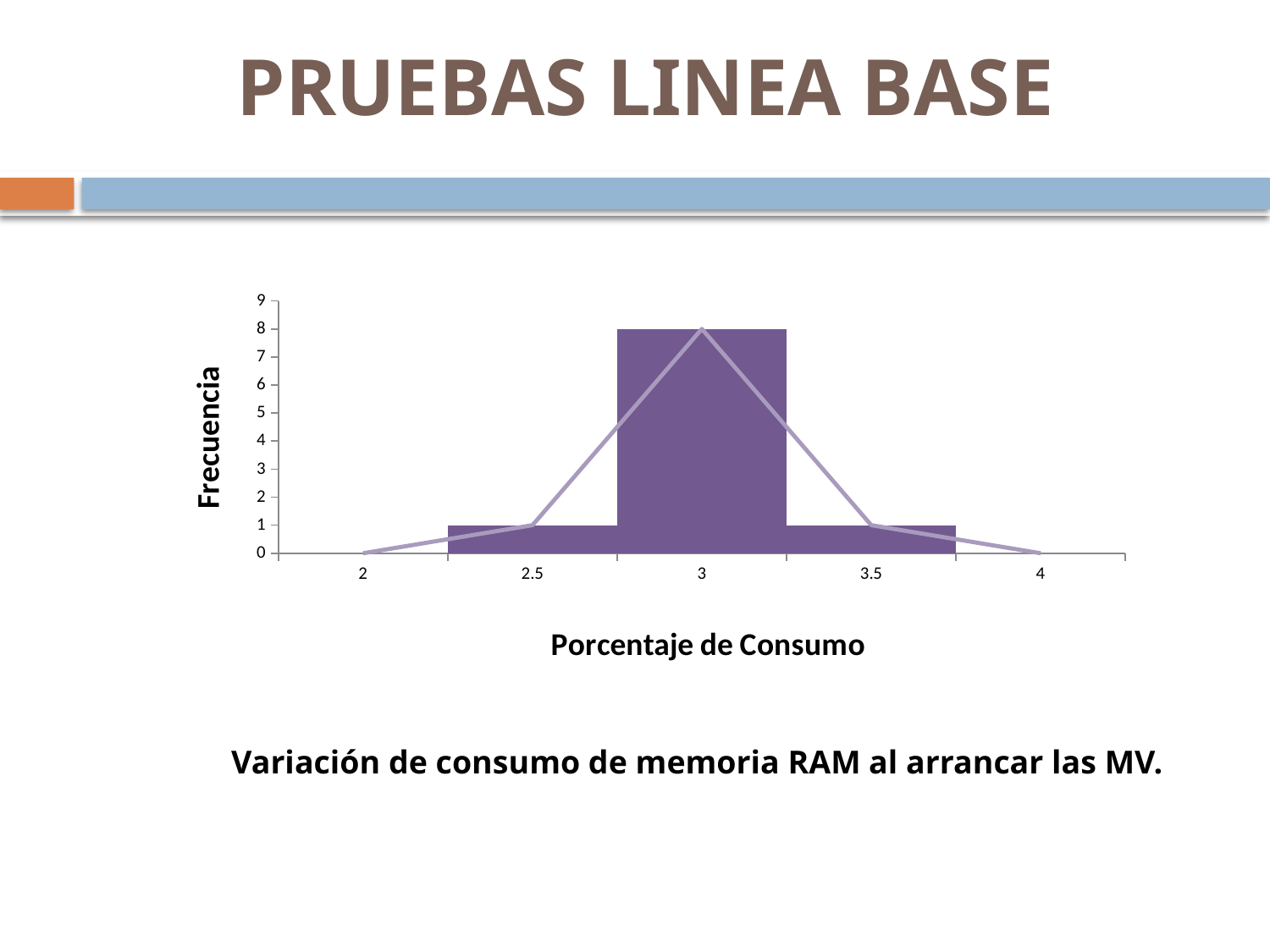
What is the label of the horizontal axis? Porcentaje de Consumo What is the frequency for a consumption percentage of 3? 8 What is the frequency for a consumption percentage of 3.5? 1 Which has a higher frequency, consumption percentage 3 or 3.5? 3 Does the frequency rise or fall from consumption percentage 3 to 3.5? fall What is the label of the vertical axis? Frecuencia How many bars are plotted in the chart? 3 What is the value of the line at a consumption percentage of 2? 0 Is the frequency for consumption percentage 3 greater or less than 5? greater What is the frequency for a consumption percentage of 2.5? 1 Which consumption percentage has the highest frequency? 3 What is the difference in frequency between consumption percentages 3 and 2.5? 7